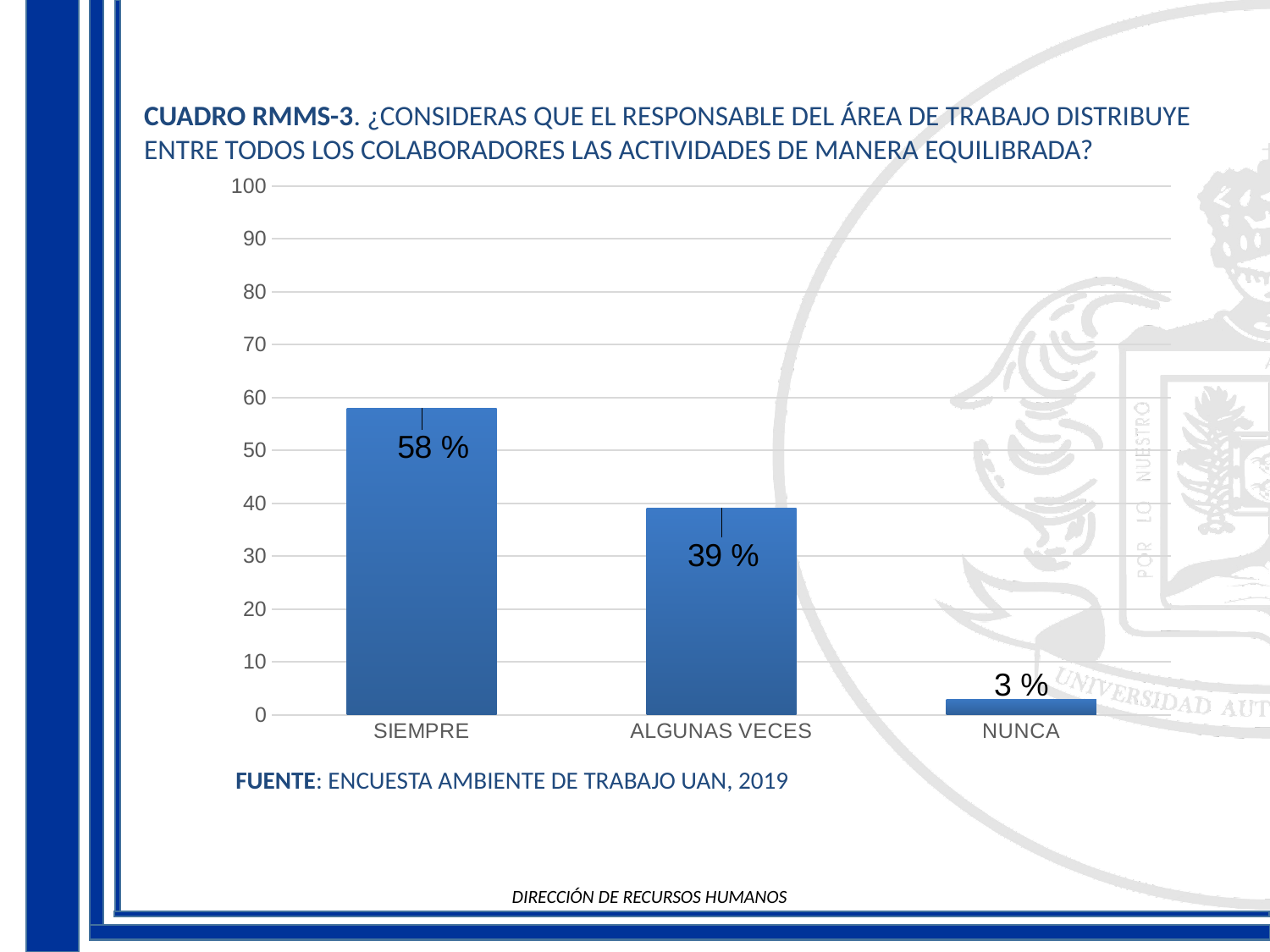
What kind of chart is shown on the slide? bar chart What is the value for NUNCA? 3 % Which category has the highest value? SIEMPRE What source is cited below the chart? ENCUESTA AMBIENTE DE TRABAJO UAN, 2019 How many categories are shown on the x axis? 3 Do the values rise or fall from left to right along the x axis? fall What is the value for SIEMPRE? 58 % Which category has the lowest value? NUNCA What is the difference between the values for SIEMPRE and ALGUNAS VECES? 19 % Is the value for ALGUNAS VECES greater or less than 50? less What is the value for ALGUNAS VECES? 39 % Which is larger, the value for ALGUNAS VECES or the value for NUNCA? ALGUNAS VECES